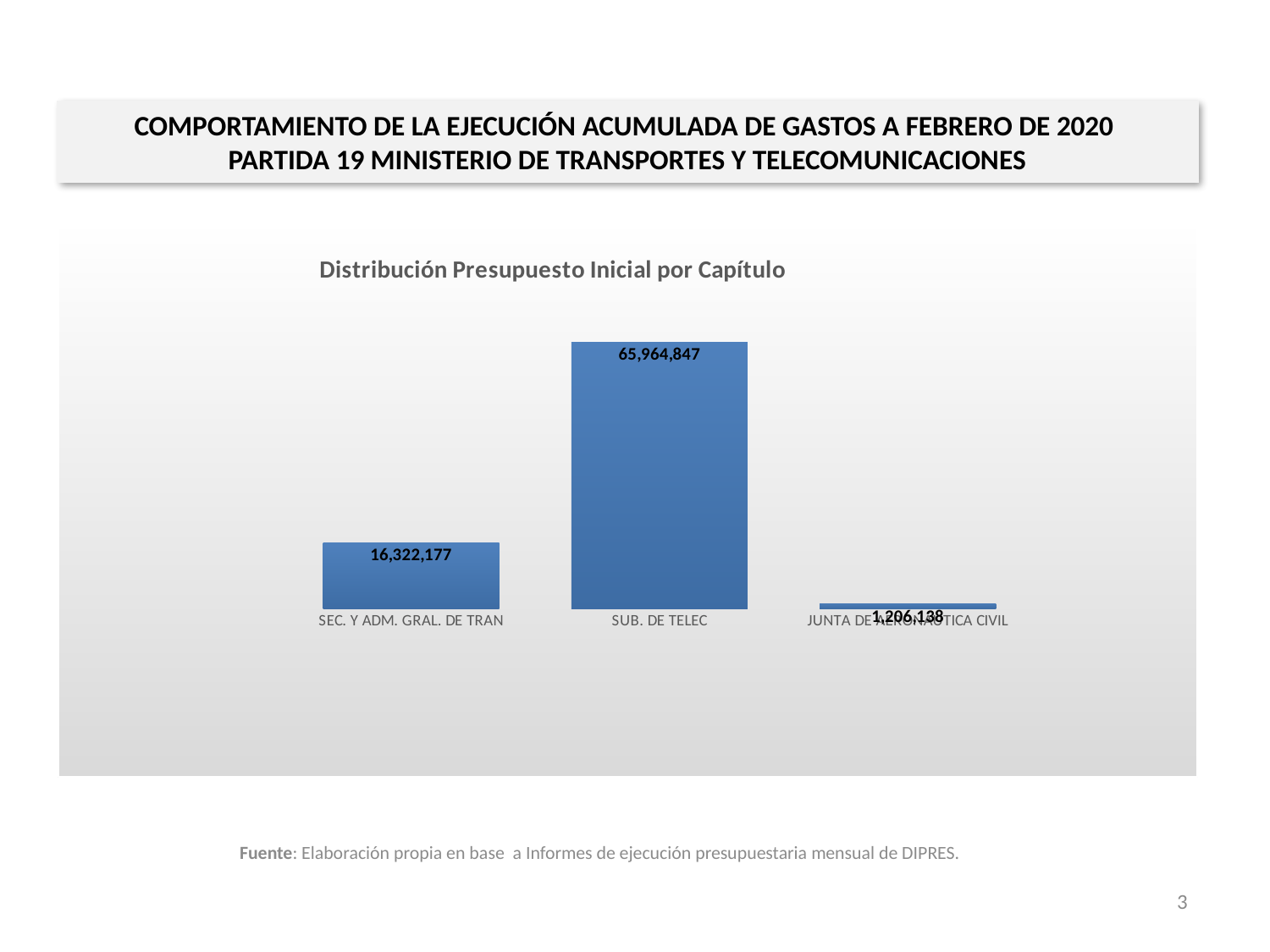
What is the value for JUNTA DE AERONÁUTICA CIVIL? 1,206,138 What is the difference between the values for SEC. Y ADM. GRAL. DE TRAN and JUNTA DE AERONÁUTICA CIVIL? 15,116,039 What is the difference between the values for SUB. DE TELEC and SEC. Y ADM. GRAL. DE TRAN? 49,642,670 What kind of chart is shown on the slide? Bar chart Which is larger, the value for SEC. Y ADM. GRAL. DE TRAN or the value for JUNTA DE AERONÁUTICA CIVIL? SEC. Y ADM. GRAL. DE TRAN What is the value for SUB. DE TELEC in the Distribución Presupuesto Inicial por Capítulo chart? 65,964,847 What is the value for SEC. Y ADM. GRAL. DE TRAN? 16,322,177 What is the sum of the values of the three categories in the chart? 83,493,162 Which category has the lowest value? JUNTA DE AERONÁUTICA CIVIL Which category has the highest value? SUB. DE TELEC What is the title of the chart? Distribución Presupuesto Inicial por Capítulo How many categories are shown in the chart? 3